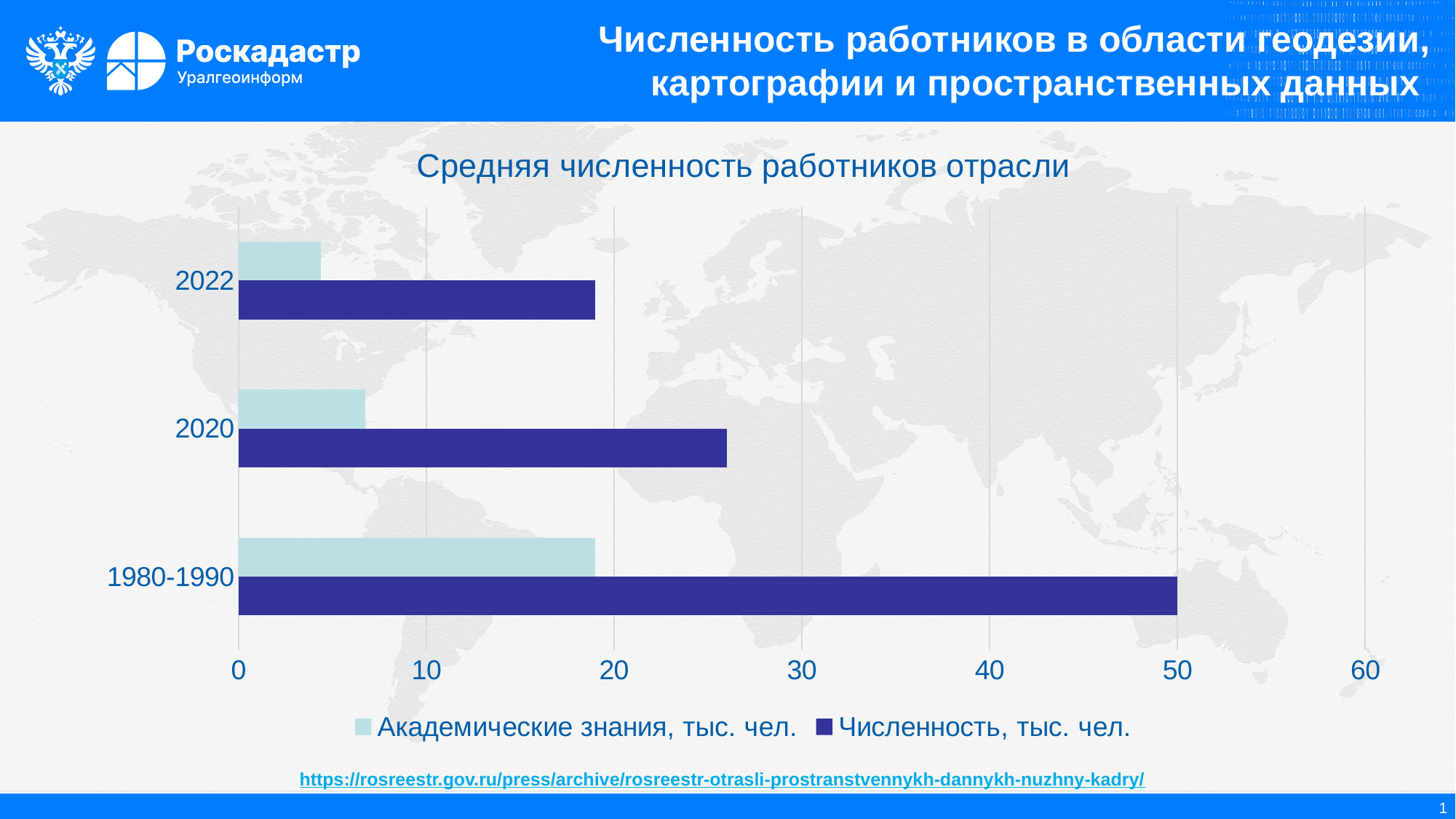
What is the title of the chart? Средняя численность работников отрасли Which series is shown in dark blue in the legend? Численность, тыс. чел. How many series does the legend list? 2 Going from 1980-1990 to 2020 to 2022, does the value for Численность, тыс. чел. rise or fall? fall Is the value for Академические знания, тыс. чел. in 2020 greater or less than 10? less Is the value for Численность, тыс. чел. in 2020 greater or less than 20? greater Which category has the lowest value for Академические знания, тыс. чел.? 2022 How many categories are shown on the vertical axis of the chart? 3 Which category has the highest value for Численность, тыс. чел.? 1980-1990 What kind of chart is shown on the slide? bar chart Which is larger: Численность, тыс. чел. in 2020 or in 2022? 2020